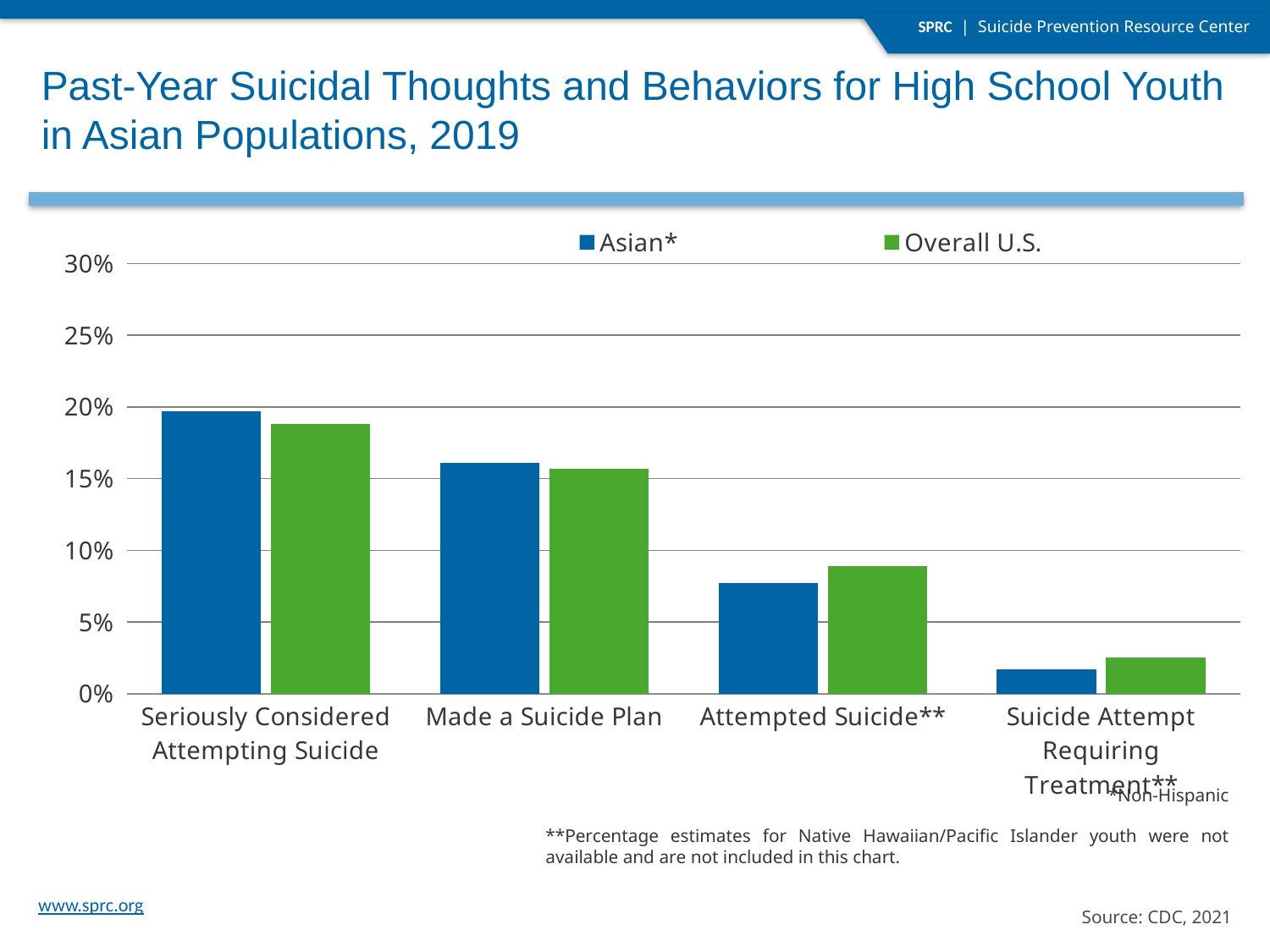
Is the Asian* value for Seriously Considered Attempting Suicide greater or less than 15%? greater For Attempted Suicide**, which series has the larger value, Asian* or Overall U.S.? Overall U.S. Which category has the lowest value for the Overall U.S. series? Suicide Attempt Requiring Treatment** Is the Overall U.S. value for Attempted Suicide** greater or less than 10%? less Do the Asian* values rise or fall moving from left to right across the categories? fall Is the Asian* value for Made a Suicide Plan greater or less than 15%? greater Which category has the highest value for the Asian* series? Seriously Considered Attempting Suicide How many series does the legend list? 2 What kind of chart is shown on the slide? bar chart How many categories are shown on the x axis? 4 What colour are the bars for the Overall U.S. series? green